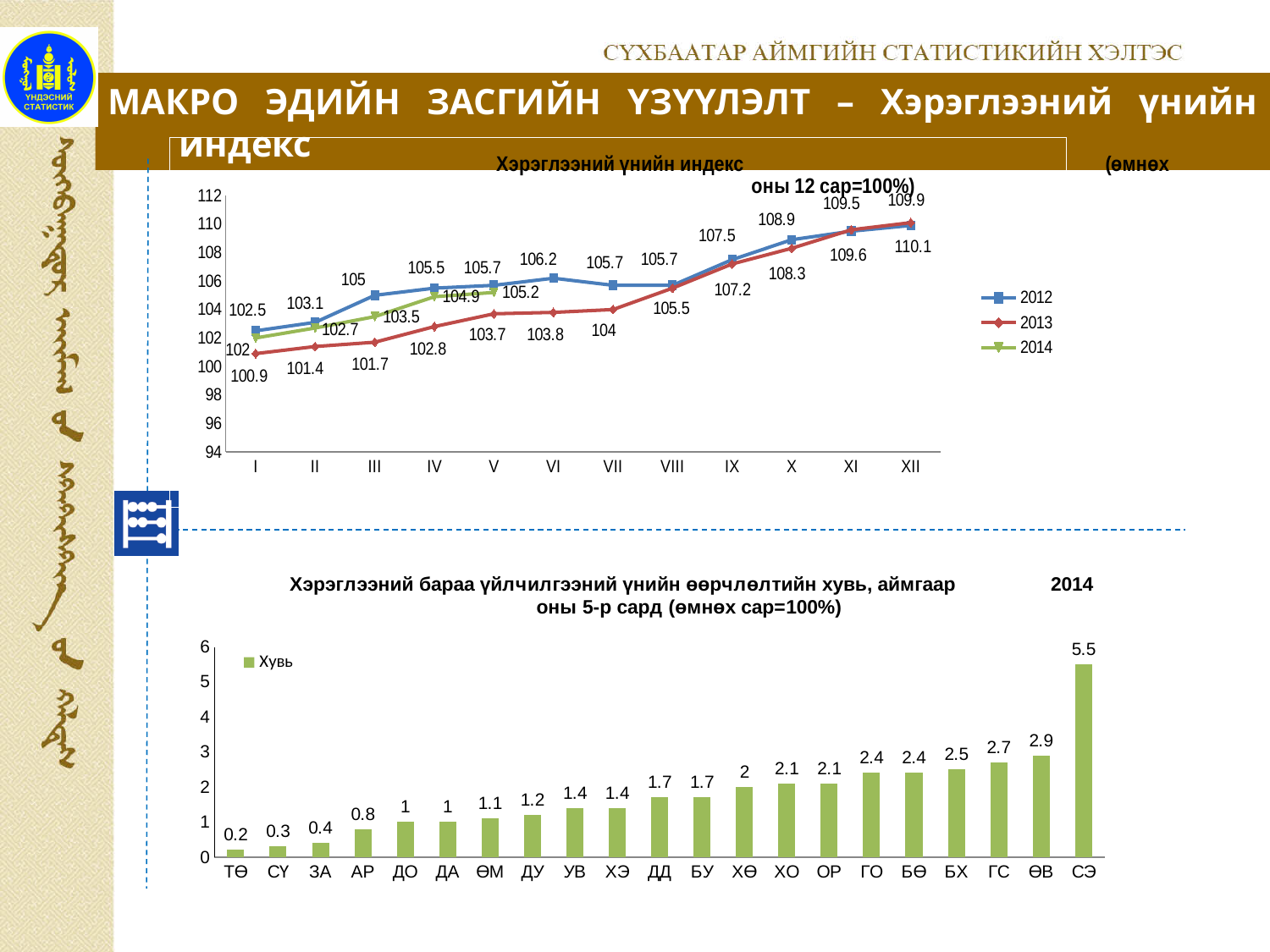
What kind of chart is the bottom chart? bar chart In the top line chart, what is the value for the 2012 series in month VI? 106.2 In the top line chart, does the 2013 series generally rise or fall from month I to month XII? rise In the top line chart, what is the value for the 2014 series in month V? 105.2 In the bottom chart, what is the value for ГС? 2.7 In the bottom chart, which category has the lowest value? ТӨ In the bottom chart, how many categories are shown on the x axis? 21 In the top line chart, what is the value for the 2013 series in month XII? 110.1 In the bottom chart, what is the difference between the values for СЭ and ӨВ? 2.6 In the top line chart, how many series does the legend list? 3 In the bottom chart, which category has the highest value? СЭ In the top line chart, what is the difference between the 2012 and 2013 values in month I? 1.6